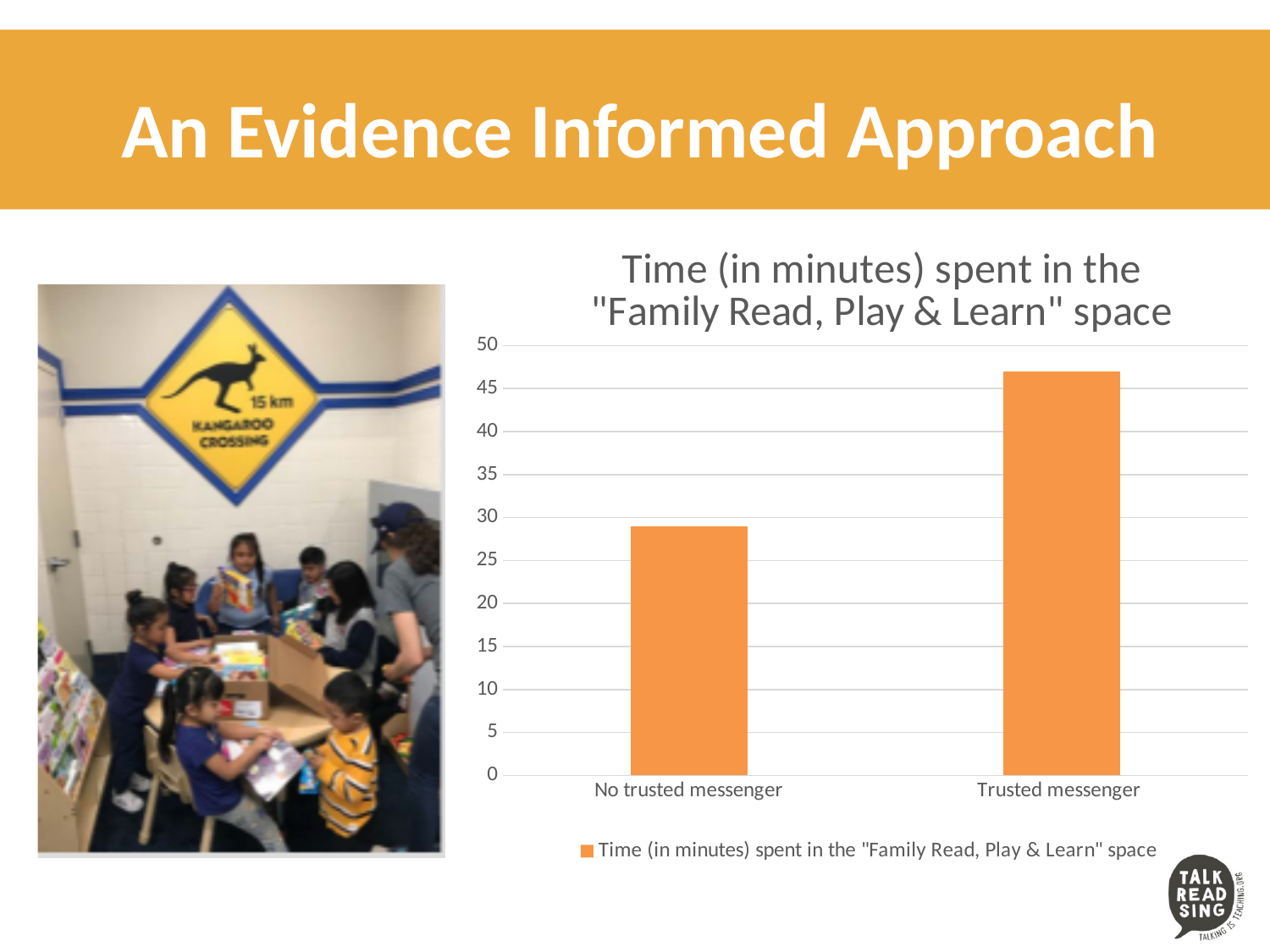
Which category has the highest value in the chart? Trusted messenger What is the title of the chart? Time (in minutes) spent in the "Family Read, Play & Learn" space Is the value for No trusted messenger greater or less than 25? greater How many series does the chart's legend list? 1 What kind of chart is shown on the slide? bar chart Is the value for Trusted messenger greater or less than 45? greater Is the value for Trusted messenger greater or less than 50? less How many categories are shown on the x axis of the chart? 2 Which is larger: the value for Trusted messenger or the value for No trusted messenger? Trusted messenger What is the maximum value shown on the chart's vertical axis? 50 Which category has the lowest value in the chart? No trusted messenger